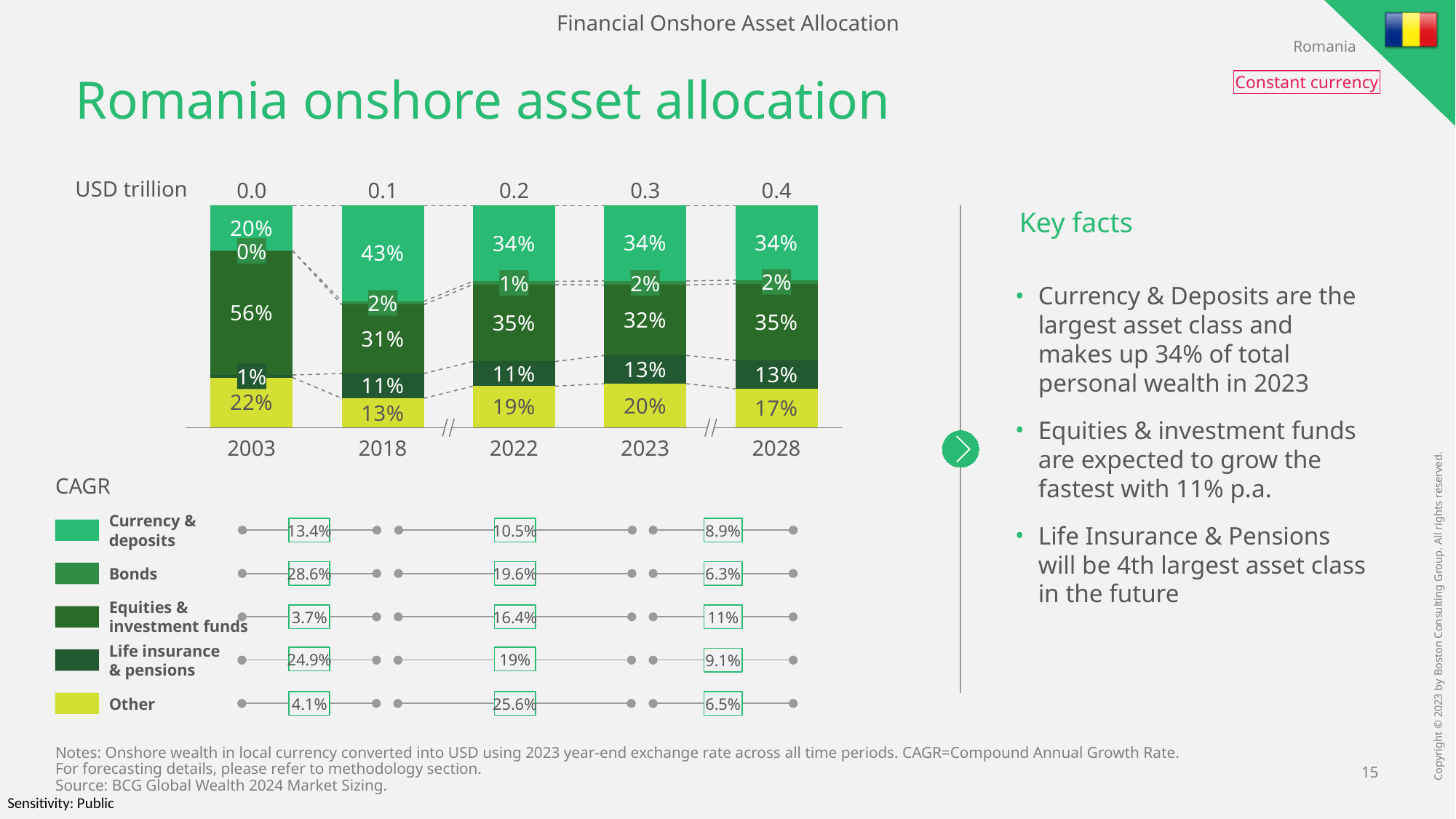
What is the difference between the Currency & deposits share in 2018 and in 2023? 9 percentage points Which is larger in 2022: the share of Equities & investment funds or the share of Currency & deposits? Equities & investment funds How many asset classes does the legend list? 5 Which year has the lowest share for Life insurance & pensions? 2003 What share of onshore assets did Equities & investment funds make up in 2003? 56% What share of onshore assets did Currency & deposits make up in 2018? 43% What is the total onshore wealth in USD trillion shown above the 2028 bar? 0.4 Which year has the highest share for Equities & investment funds? 2003 What type of chart is used to show the Romania onshore asset allocation by year? Stacked bar chart What is the share of Other in 2023? 20% How many years are shown on the x axis of the asset allocation bar chart? 5 What is the CAGR for Bonds in the first period (2003–2018) shown in the CAGR table? 28.6%